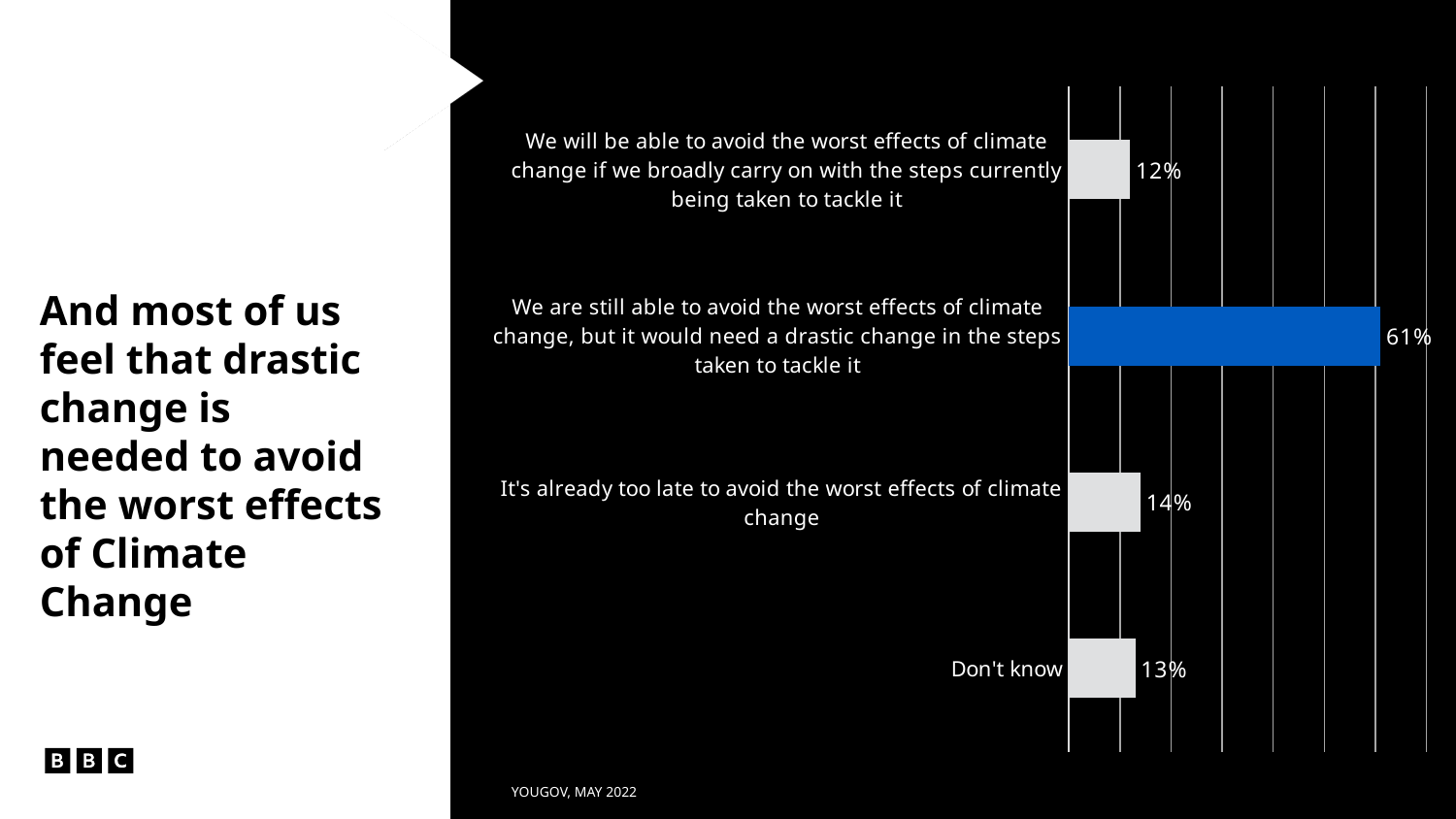
Which response option has the highest percentage? We are still able to avoid the worst effects of climate change, but it would need a drastic change in the steps taken to tackle it What percentage of respondents said it's already too late to avoid the worst effects of climate change? 14% How many response categories are shown in the chart? 4 What percentage of respondents said we will be able to avoid the worst effects of climate change if we broadly carry on with the steps currently being taken? 12% Which bar is highlighted in blue rather than grey? We are still able to avoid the worst effects of climate change, but it would need a drastic change in the steps taken to tackle it What percentage of respondents answered 'Don't know'? 13% Which is larger: the percentage for 'Don't know' or the percentage for 'carry on with the steps currently being taken'? Don't know What percentage of respondents said we are still able to avoid the worst effects of climate change but it would need a drastic change in the steps taken to tackle it? 61% Which response option has the lowest percentage? We will be able to avoid the worst effects of climate change if we broadly carry on with the steps currently being taken to tackle it What type of chart is shown on the slide? Bar chart What is the difference in percentage points between the 'drastic change' response and the 'already too late' response? 47 What is the difference in percentage points between 'It's already too late' and 'Don't know'? 1